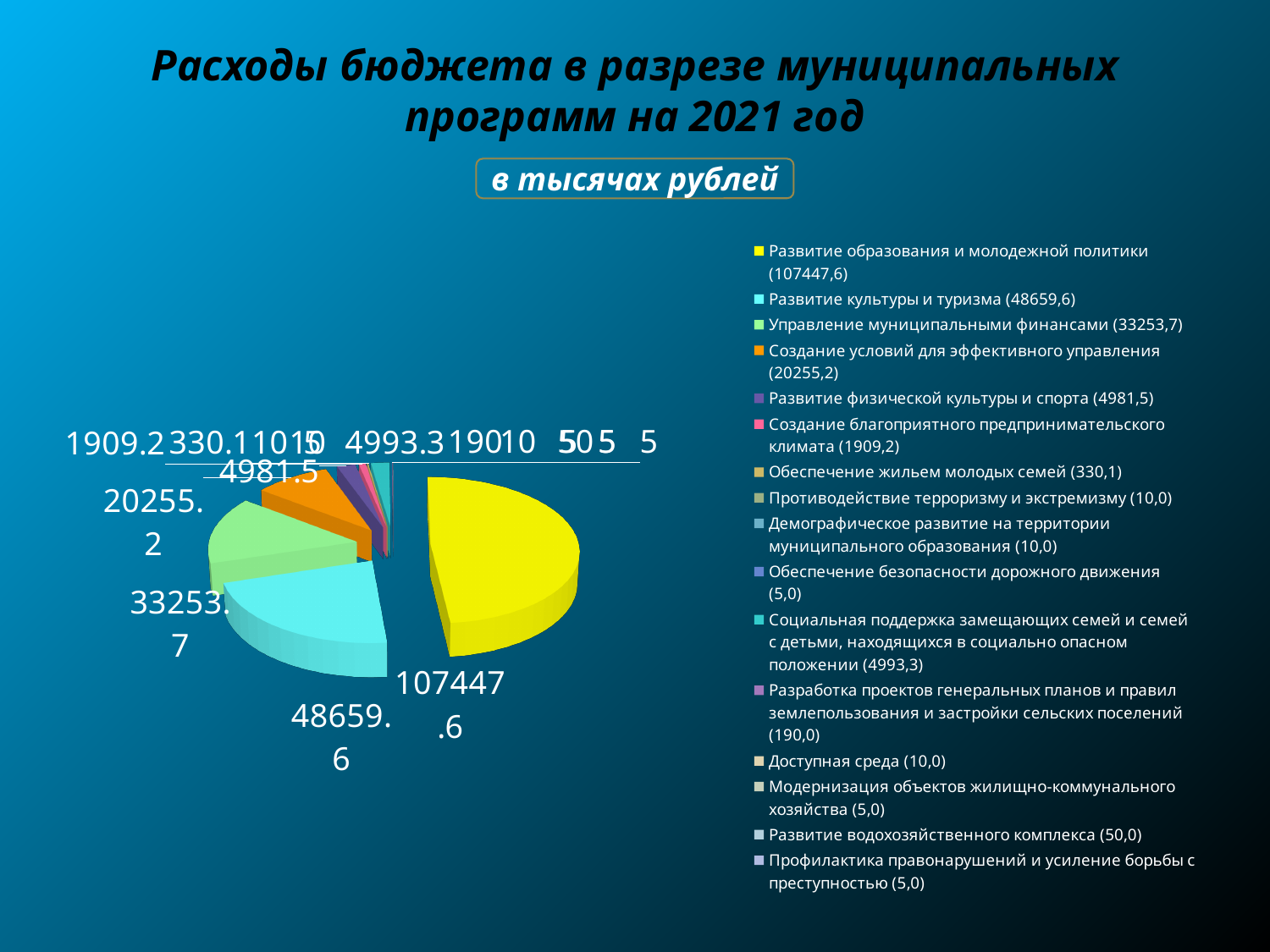
What kind of chart is shown on the slide? pie chart How many categories does the legend list? 16 What is the value for Развитие культуры и туризма? 48659.6 What is the value for Развитие образования и молодежной политики? 107447.6 Which is larger: Развитие культуры и туризма or Управление муниципальными финансами? Развитие культуры и туризма In what units are the values on the chart expressed, according to the slide? в тысячах рублей What is the difference between Управление муниципальными финансами and Создание условий для эффективного управления? 12998.5 Which category has the largest slice of the pie? Развитие образования и молодежной политики What is the value for Создание условий для эффективного управления? 20255.2 What is the difference between Развитие образования и молодежной политики and Развитие культуры и туризма? 58788 What is the value for Развитие водохозяйственного комплекса? 50 What is the value for Управление муниципальными финансами? 33253.7